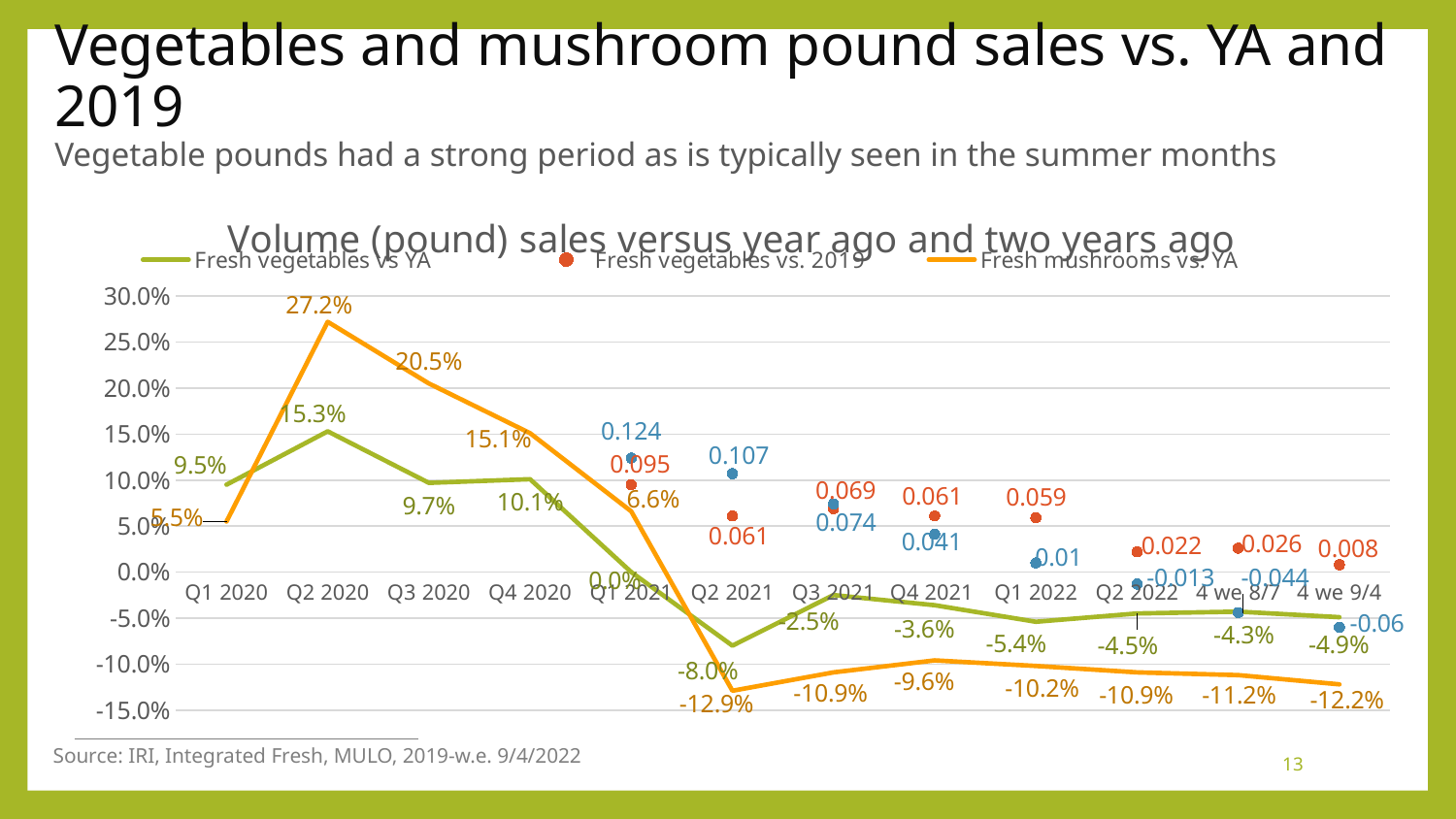
What is the value for Fresh vegetables vs YA in the 4 we 9/4 period? -4.9% In which period is Fresh vegetables vs YA lowest? Q2 2021 What is the value for Fresh vegetables vs YA in Q2 2021? -8.0% How many periods are shown on the x axis? 12 What is the value for Fresh vegetables vs. 2019 in Q1 2021? 0.095 What is the value for Fresh mushrooms vs. YA in Q2 2020? 27.2% In which period is Fresh mushrooms vs. YA highest? Q2 2020 In which period is Fresh mushrooms vs. YA lowest? Q2 2021 What kind of chart is this? Line chart What is the difference between Fresh mushrooms vs. YA and Fresh vegetables vs YA in Q2 2020? 11.9 percentage points In Q3 2020, which is larger: Fresh vegetables vs YA or Fresh mushrooms vs. YA? Fresh mushrooms vs. YA How many series does the legend list? 3